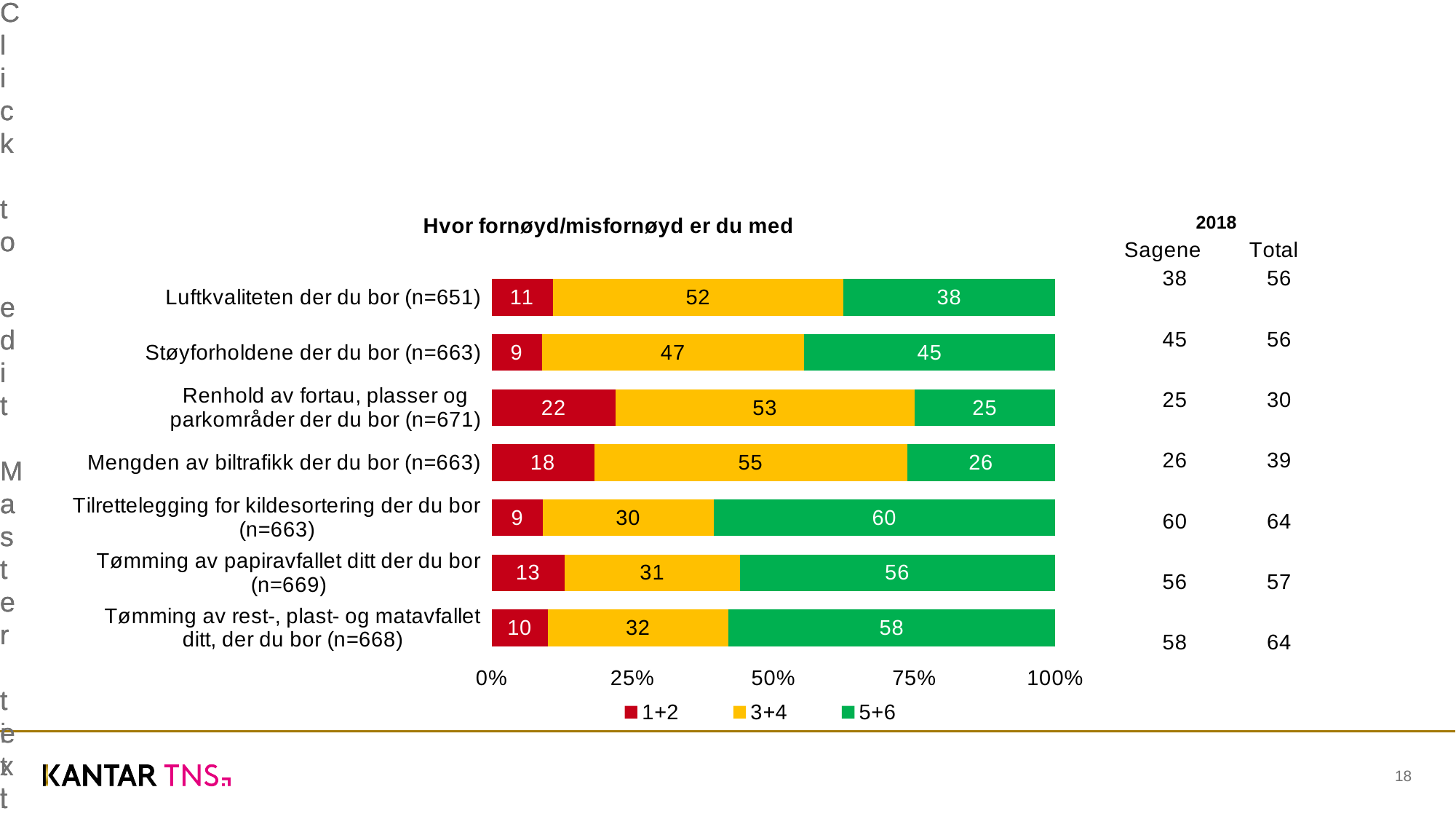
Which category has the highest 1+2 value? Renhold av fortau, plasser og parkområder der du bor (n=671) How many series does the legend list? 3 What is the 5+6 value for "Tilrettelegging for kildesortering der du bor (n=663)"? 60 What is the 1+2 value for "Renhold av fortau, plasser og parkområder der du bor (n=671)"? 22 Which category has the lowest 5+6 value? Renhold av fortau, plasser og parkområder der du bor (n=671) What is the total of the stacked bar for "Tømming av papiravfallet ditt der du bor (n=669)"? 100 What is the 3+4 value for "Mengden av biltrafikk der du bor (n=663)"? 55 How many categories are plotted in the chart? 7 What is the title of the chart? Hvor fornøyd/misfornøyd er du med What kind of chart is shown on the slide? Stacked bar chart What is the difference between the 5+6 values for "Støyforholdene der du bor (n=663)" and "Luftkvaliteten der du bor (n=651)"? 7 Which is larger: the 3+4 value for "Luftkvaliteten der du bor (n=651)" or the 3+4 value for "Støyforholdene der du bor (n=663)"? Luftkvaliteten der du bor (n=651)